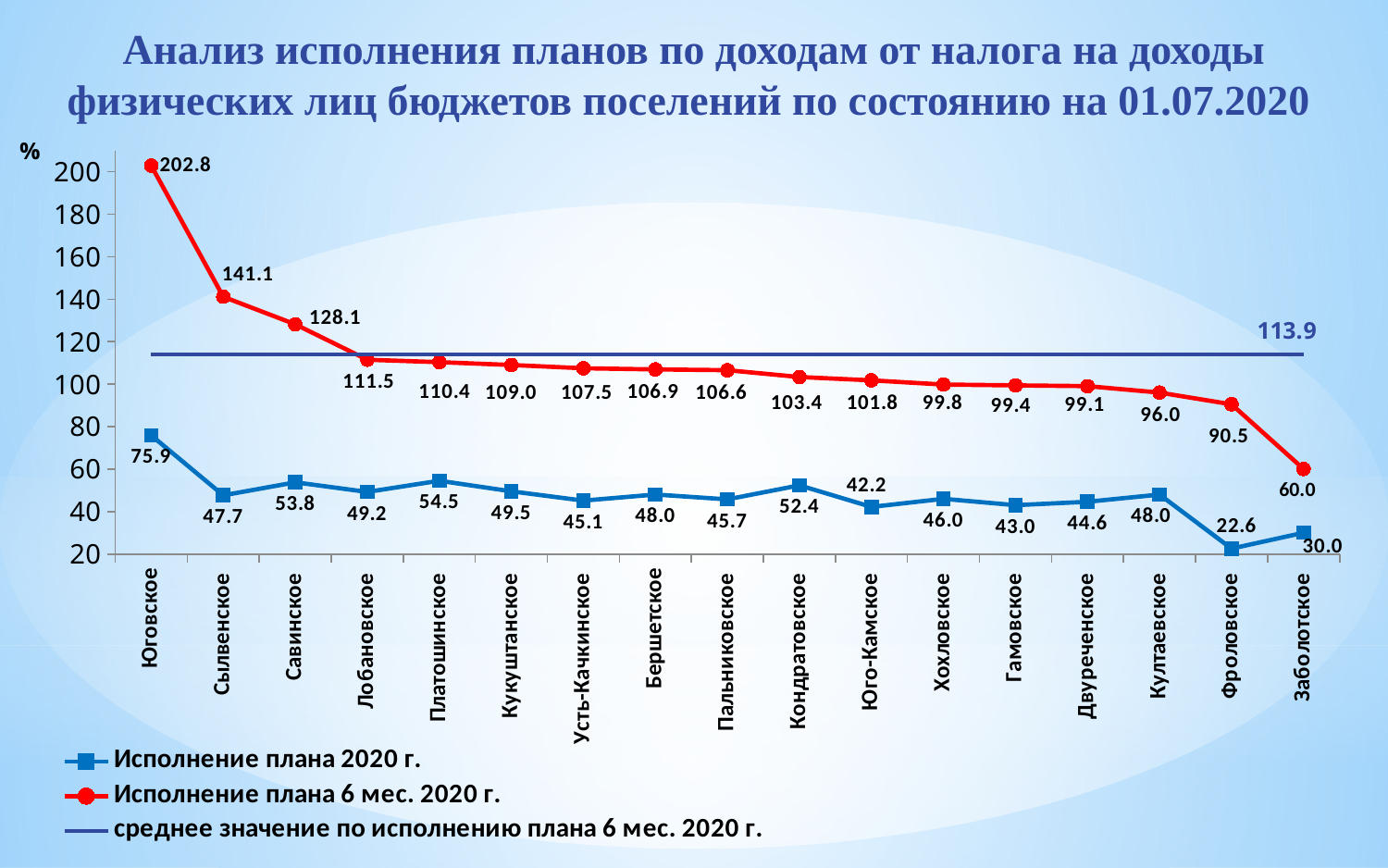
What is the value of 'Исполнение плана 6 мес. 2020 г.' for Заболотское? 60.0 What type of chart is shown on the slide? line chart What is the value of 'Исполнение плана 2020 г.' for Фроловское? 22.6 Is the 'Исполнение плана 6 мес. 2020 г.' value for Фроловское greater or less than 100? less What is the value of the average line 'среднее значение по исполнению плана 6 мес. 2020 г.'? 113.9 What is the difference between the 'Исполнение плана 6 мес. 2020 г.' values for Сылвенское and Савинское? 13.0 How many settlements are shown on the x axis? 17 Which settlement has the lowest value for 'Исполнение плана 2020 г.'? Фроловское Which is larger: the 'Исполнение плана 2020 г.' value for Платошинское or for Кондратовское? Платошинское How many entries does the legend list? 3 Which settlement has the highest value for 'Исполнение плана 6 мес. 2020 г.'? Юговское What is the value of 'Исполнение плана 6 мес. 2020 г.' for Юговское? 202.8